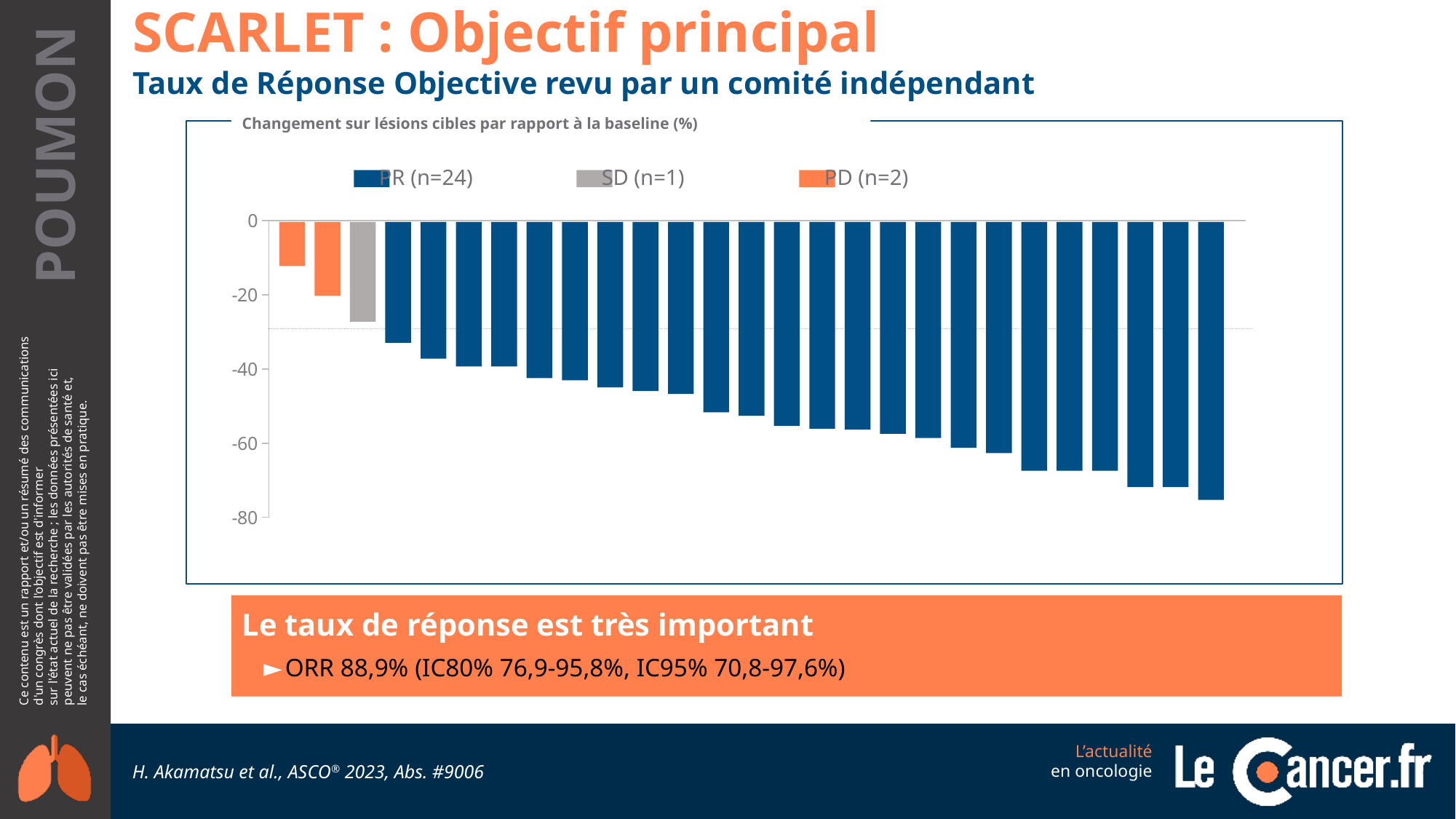
How many patients are in the PD group according to the legend? 2 How many patients are in the PR group according to the legend? 24 How many patients are in the SD group according to the legend? 1 Which legend group has the most bars in the chart? PR (n=24) How many bars are plotted in the chart in total? 27 Do the bar values rise or fall from left to right along the x axis? Fall Is the value of the leftmost orange bar greater or less than -20? greater How many series does the legend list? 3 What colour are the PD bars in the chart? Orange Is the value of the rightmost blue bar greater or less than -60? less What kind of chart is shown on the slide? Bar chart Is the value of the gray SD bar greater or less than -20? less